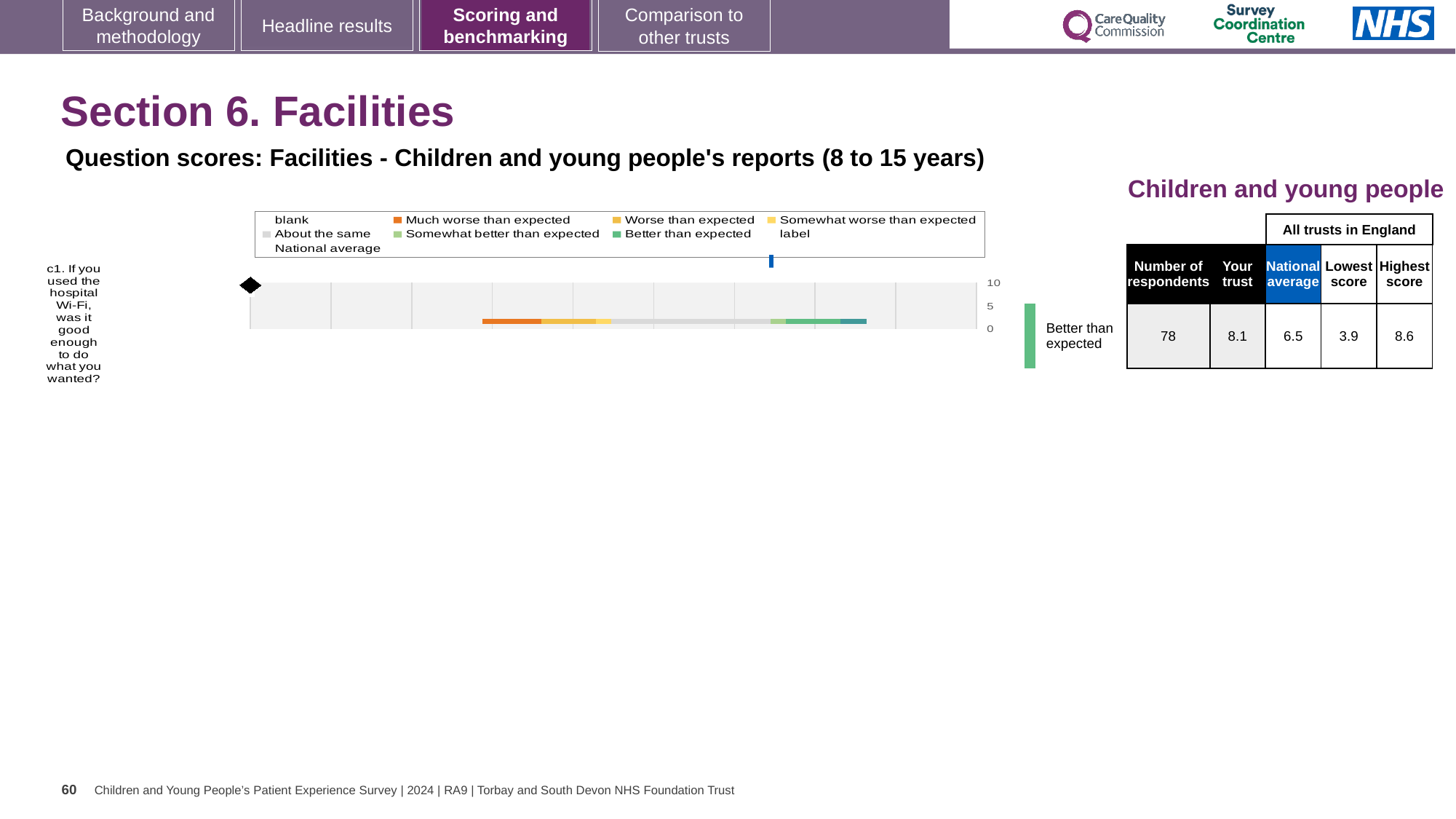
In the table next to the chart, what is the National average for question c1? 6.5 Which is larger for question c1: the 'Your trust' score or the National average? Your trust In the table next to the chart, how many respondents answered question c1? 78 What colour does the legend use for 'Much worse than expected'? orange How many questions (categories) are plotted in the chart? 1 In the table next to the chart, what is the Highest score among all trusts in England for question c1? 8.6 In the table next to the chart, what is the 'Your trust' score for question c1? 8.1 In the table next to the chart, what is the Lowest score among all trusts in England for question c1? 3.9 What kind of chart is shown on the slide? bar chart Which question is plotted in the chart? c1. If you used the hospital Wi-Fi, was it good enough to do what you wanted? What is the difference between the 'Your trust' score and the National average for question c1? 1.6 How many entries does the chart legend list? 9